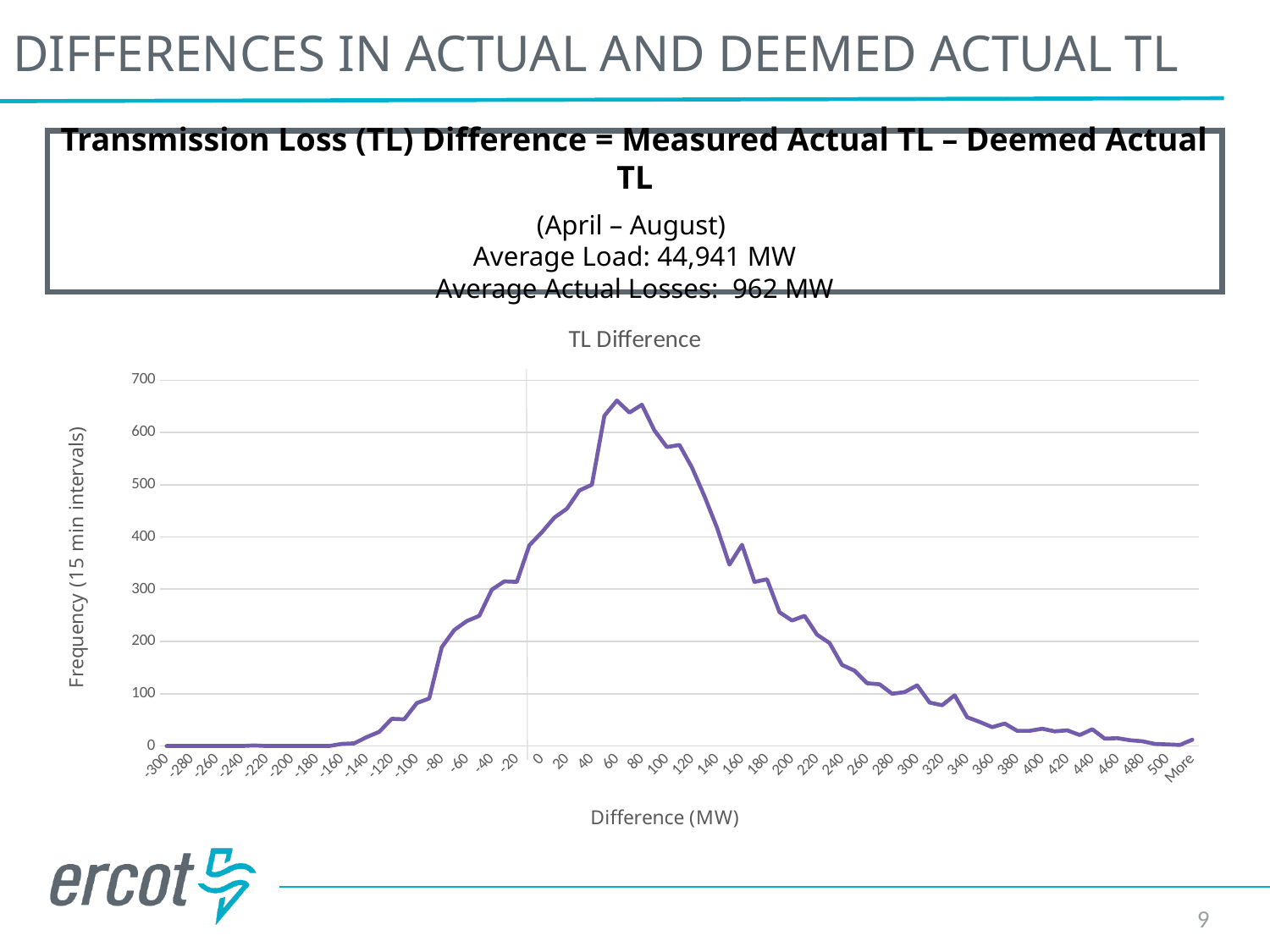
What is the label of the vertical axis of the chart? Frequency (15 min intervals) Does the frequency generally rise or fall as the difference goes from -160 MW to 60 MW? rise Is the frequency value at a difference of -100 MW greater or less than 100? less Is the frequency value at a difference of 200 MW greater or less than 200? greater Is the frequency value at a difference of -200 MW greater or less than 100? less What is the title of the chart? TL Difference Does the frequency generally rise or fall as the difference goes from 100 MW to 500 MW? fall What kind of chart is shown on the slide? line chart